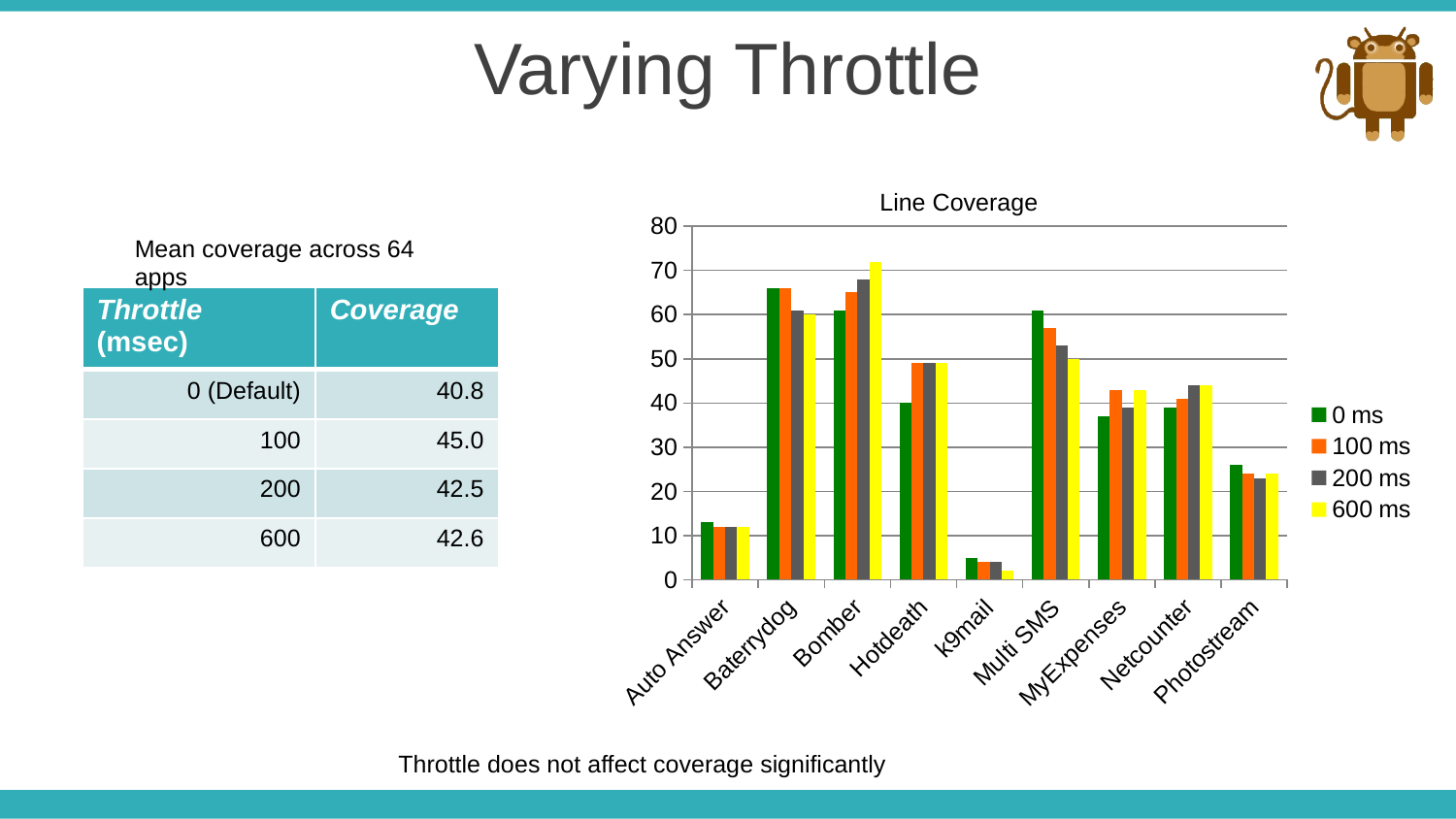
Which app has the highest line coverage for the 600 ms series? Bomber Which app has the highest line coverage for the 0 ms series? Baterrydog Is the 600 ms line coverage for Bomber greater or less than 60? greater What is the title of the chart? Line Coverage Is the 0 ms line coverage for Hotdeath greater or less than 50? less For Multi SMS, which series has the larger line coverage, 0 ms or 600 ms? 0 ms How many apps (categories) are shown on the x axis of the chart? 9 What kind of chart is shown on the slide? bar chart Is the 0 ms line coverage for k9mail greater or less than 10? less Which app has the lowest line coverage across all throttle settings? k9mail For Bomber, which series has the larger line coverage, 0 ms or 600 ms? 600 ms How many series does the chart's legend list? 4